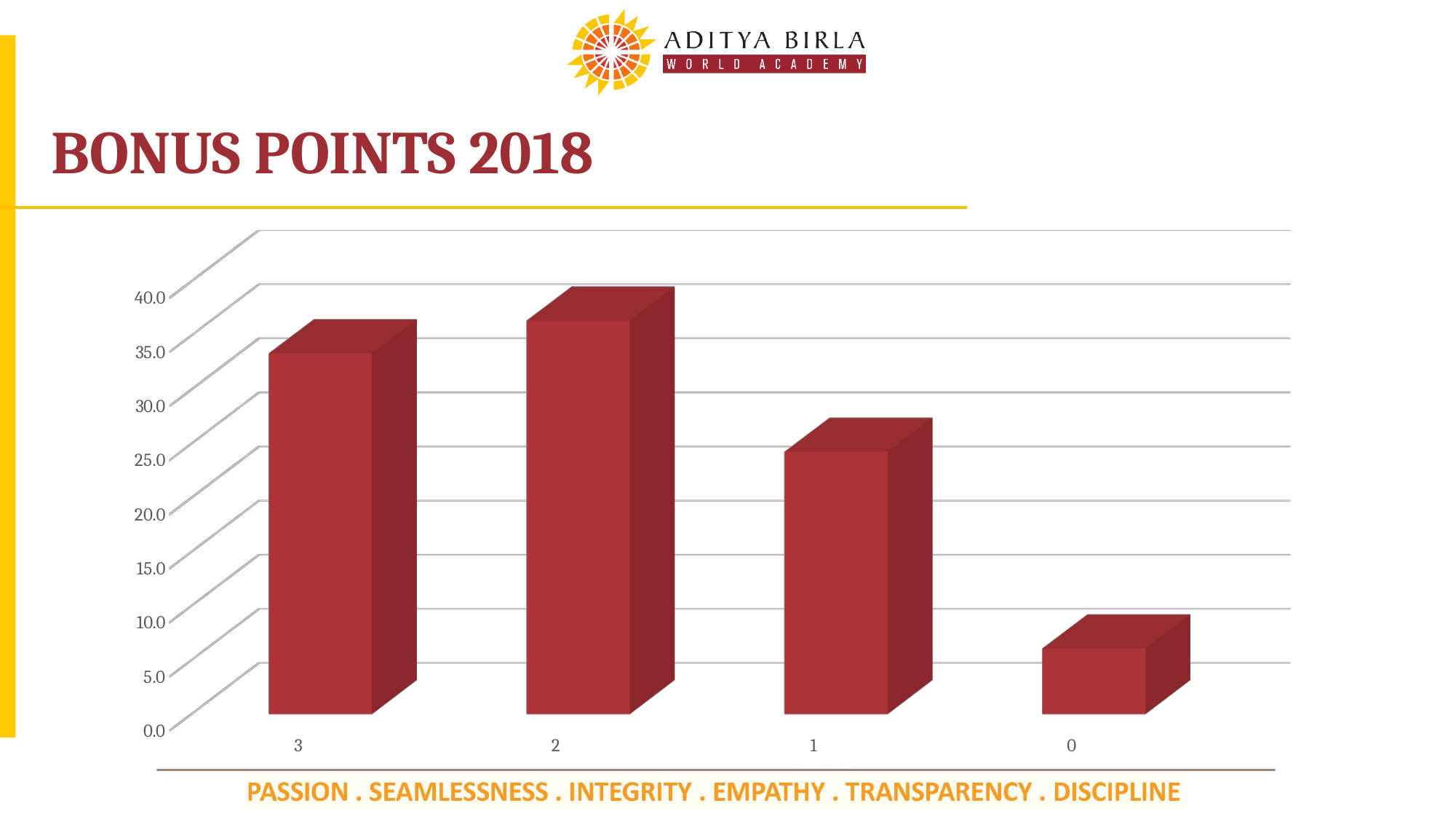
Which has the larger value, category 1 or category 0? 1 Which category has the lowest bar in the chart? 0 Is the value for category 2 greater or less than 35.0? greater What is the title of the chart on the slide? BONUS POINTS 2018 Is the value for category 1 greater or less than 30.0? less What colour are the bars in the chart? dark red Is the value for category 3 greater or less than 30.0? greater How many categories are shown on the x axis of the chart? 4 Which category has the highest bar in the chart? 2 Which has the larger value, category 3 or category 1? 3 What kind of chart is shown on the slide? bar chart